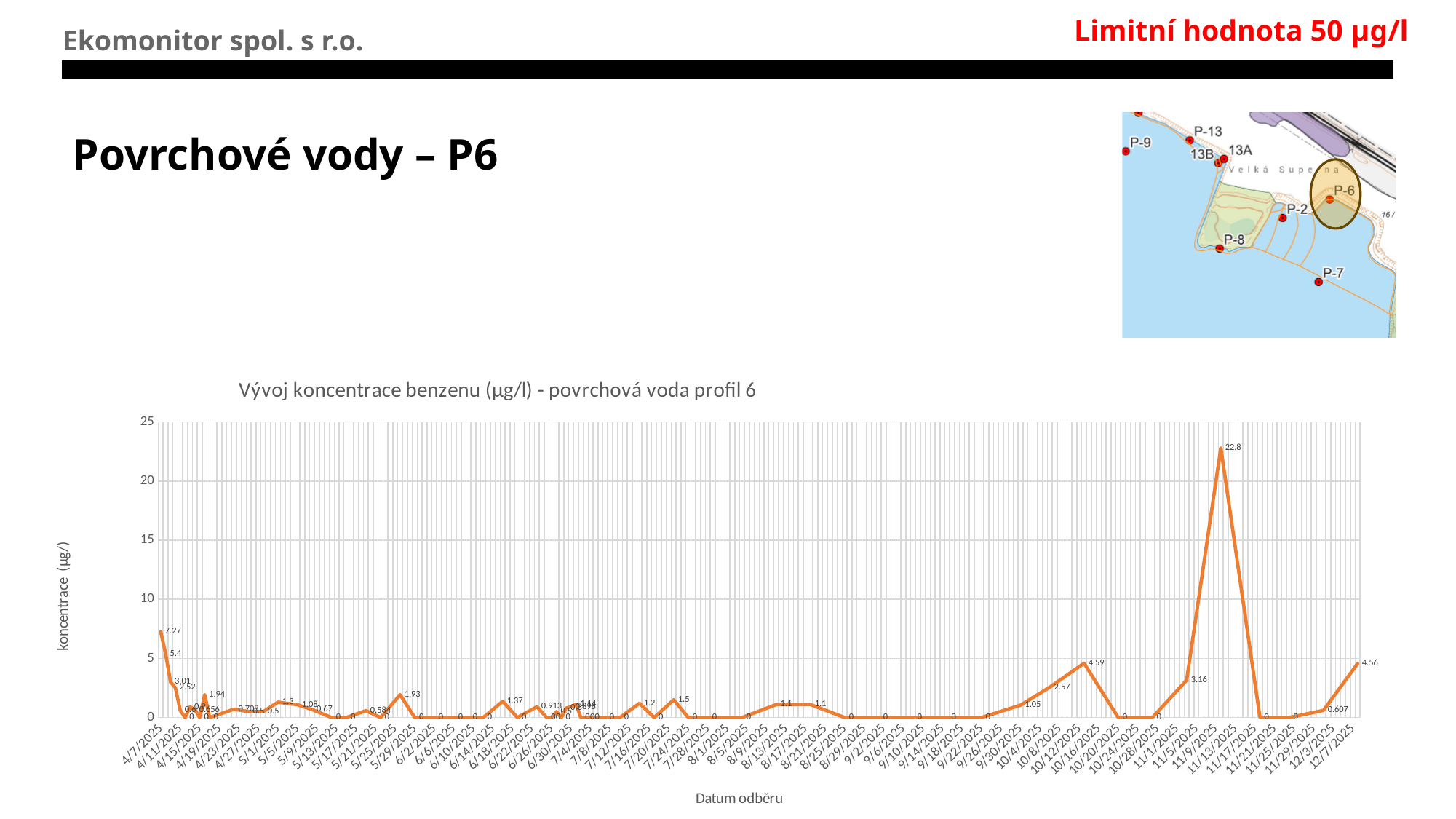
What is the label of the x axis of the chart? Datum odběru What is the benzene concentration value for 4/7/2025, the first date on the chart? 7.27 What is the highest benzene concentration value labelled on the chart? 22.8 Is the highest value on the chart greater or less than 20? greater What is the title of the chart? Vývoj koncentrace benzenu (µg/l) - povrchová voda profil 6 Is the highest value on the chart greater or less than 25? less What kind of chart is shown on the slide? line chart Is the value for 4/7/2025 greater or less than 5? greater